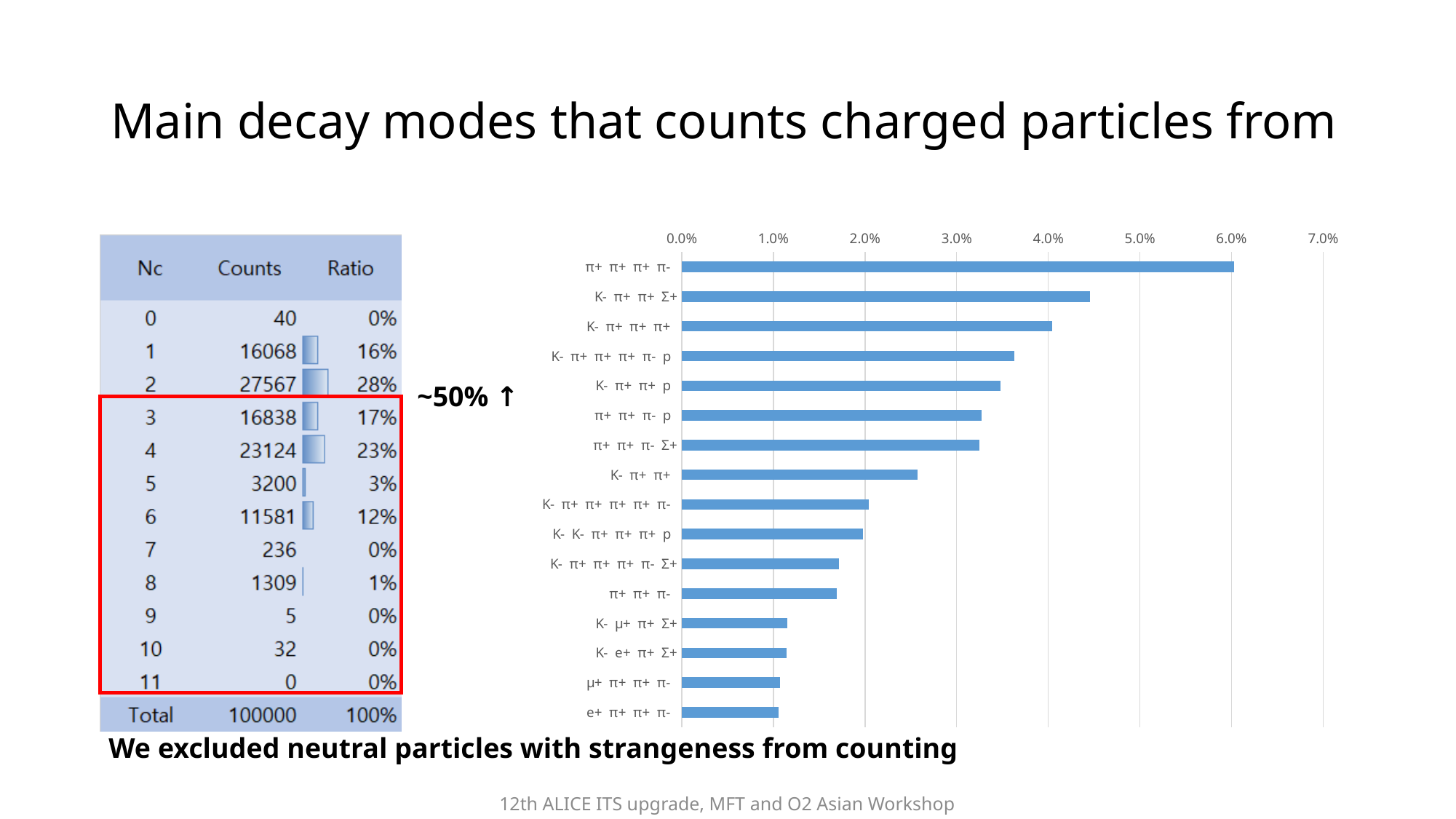
What kind of chart is shown on the right of the slide? bar chart How many decay modes are plotted in the bar chart? 16 Is the value for K- π+ π+ greater or less than 3.0%? less Is the value for π+ π+ π- greater or less than 2.0%? less Is the value for π+ π+ π+ π- greater or less than 5.0%? greater What is the maximum value shown on the percentage axis of the bar chart? 7.0% Which decay mode has the highest value in the bar chart? π+ π+ π+ π- Which is larger in the bar chart, π+ π+ π+ π- or K- π+ π+ Σ+? π+ π+ π+ π- Which is larger in the bar chart, K- π+ π+ or π+ π+ π-? K- π+ π+